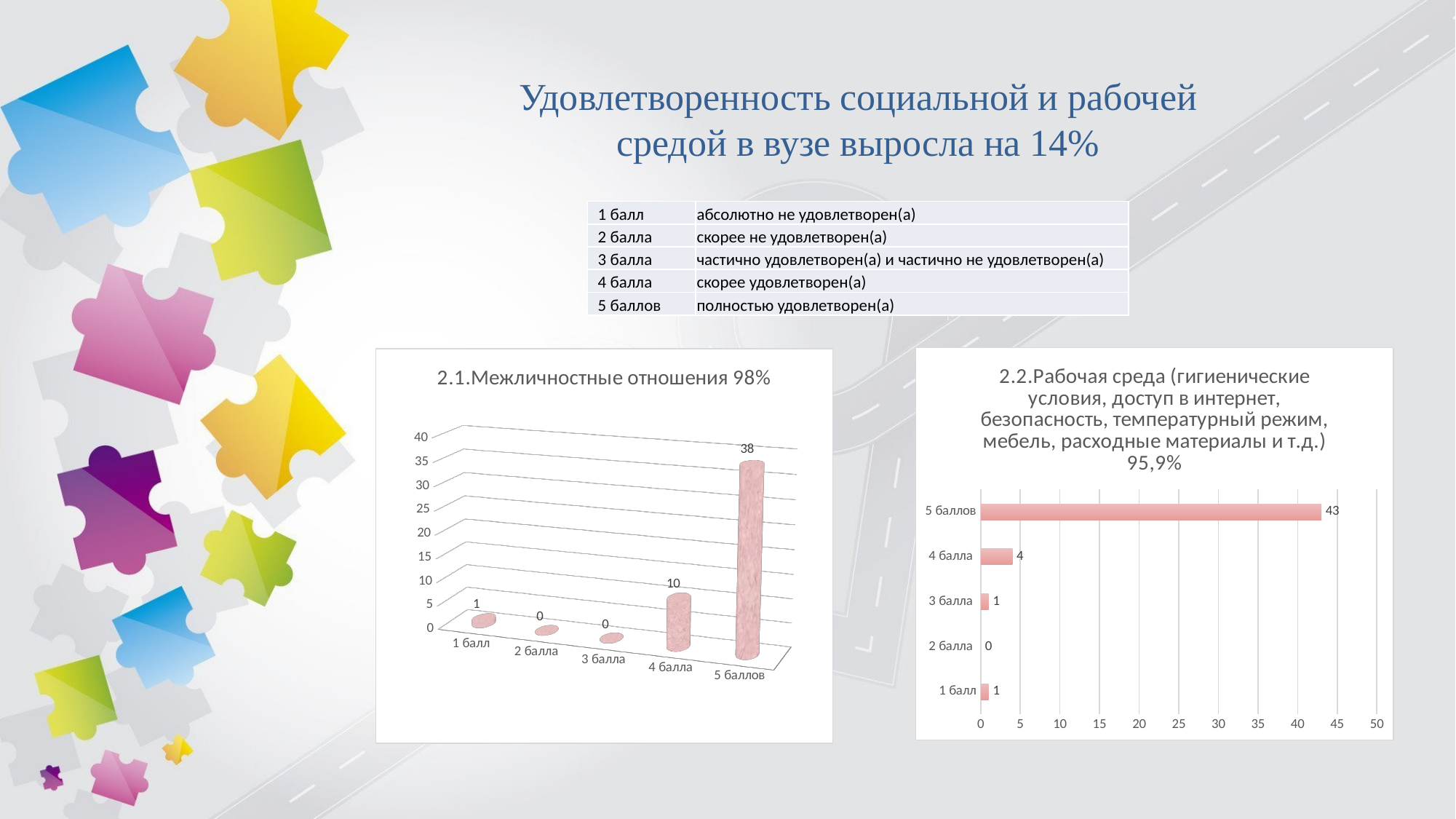
In the chart on the right (2.2.Рабочая среда), what is the value for 5 баллов? 43 In the chart on the right (2.2.Рабочая среда), what is the value for 4 балла? 4 In the chart on the right (2.2.Рабочая среда), what is the difference between the values for 5 баллов and 4 балла? 39 In the chart titled "2.1.Межличностные отношения 98%", which category has the highest value? 5 баллов In the chart titled "2.1.Межличностные отношения 98%", what is the difference between the values for 5 баллов and 4 балла? 28 In the chart on the right (2.2.Рабочая среда), which is larger: the value for 4 балла or the value for 3 балла? 4 балла In the chart titled "2.1.Межличностные отношения 98%", what is the value for 5 баллов? 38 In the chart titled "2.1.Межличностные отношения 98%", how many categories are shown on the x axis? 5 In the chart titled "2.1.Межличностные отношения 98%", what is the value for 4 балла? 10 In the chart titled "2.1.Межличностные отношения 98%", what is the value for 1 балл? 1 What type of chart is the chart on the right (2.2.Рабочая среда)? Bar chart In the chart on the right (2.2.Рабочая среда), which category has the highest value? 5 баллов